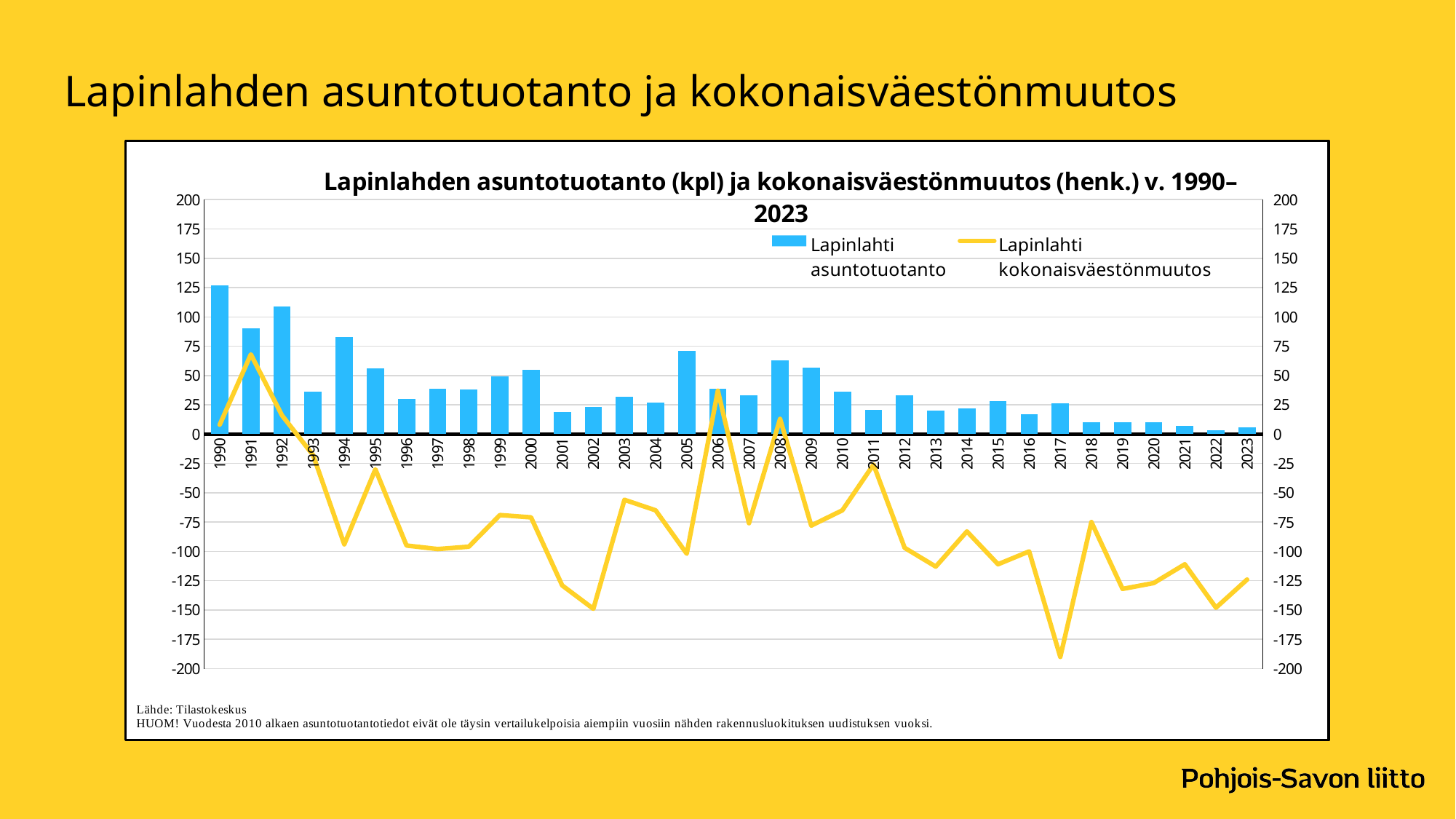
Which year has the highest value for Lapinlahti asuntotuotanto (the bars)? 1990 Which year has the highest value for Lapinlahti kokonaisväestönmuutos (the line)? 1991 Which year has the lowest value for Lapinlahti asuntotuotanto (the bars)? 2022 Which is larger, the asuntotuotanto value for 1990 or for 1992? 1990 Is the asuntotuotanto value for 1990 greater or less than 100? greater Is the asuntotuotanto value for 2005 greater or less than 50? greater Do the asuntotuotanto bars generally rise or fall from 1990 to 2023? fall What kind of chart is shown on the slide? A combined bar and line chart Is the kokonaisväestönmuutos value for 2017 greater or less than -175? less How many series does the legend list? 2 Which year has the lowest value for Lapinlahti kokonaisväestönmuutos (the line)? 2017 How many years are shown on the x axis? 34